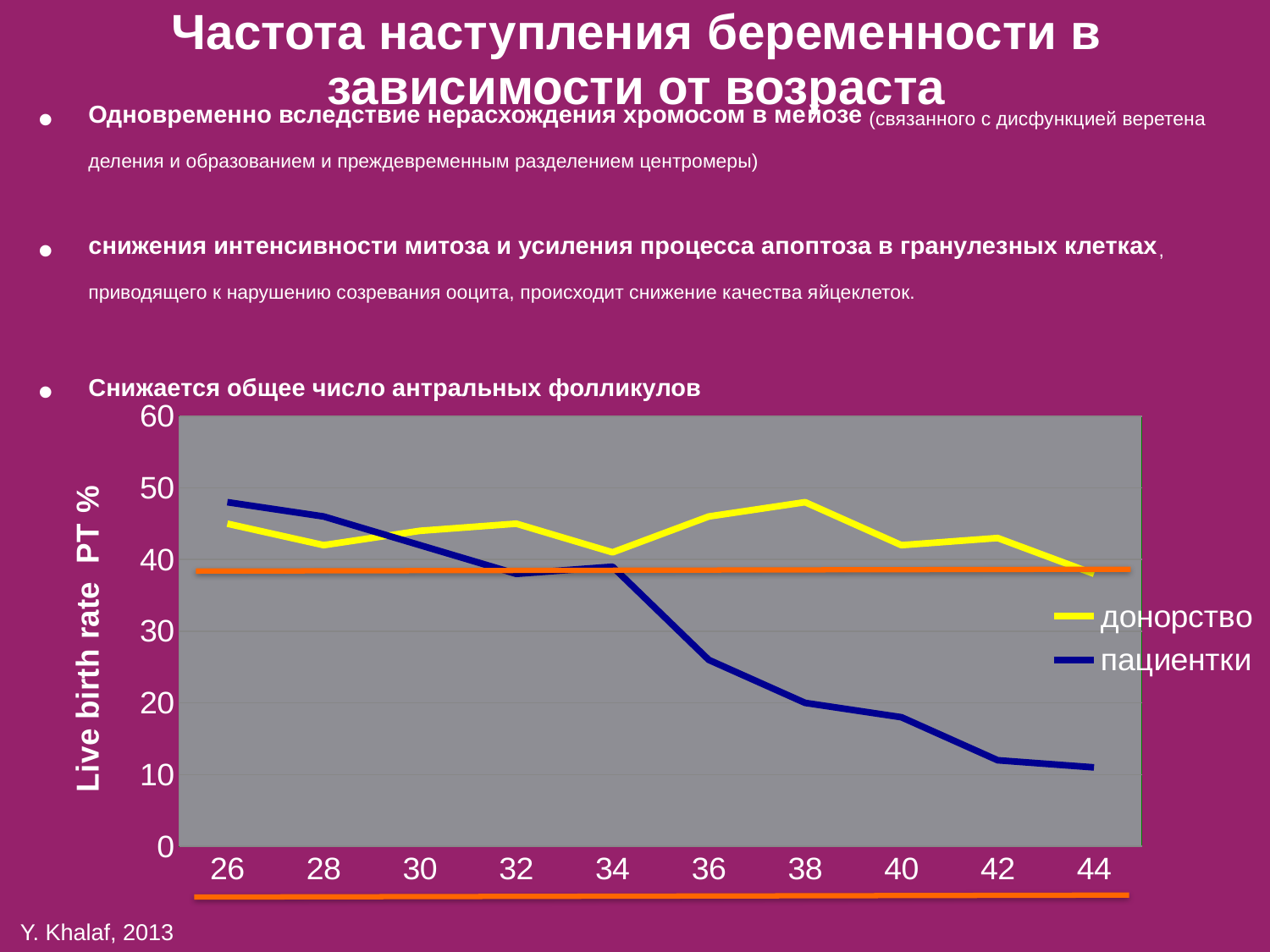
How many series does the chart legend list? 2 What are the two series named in the chart legend? донорство and пациентки What kind of chart is shown on the slide? line chart How many age values are marked along the x axis of the chart? 10 At which age is the пациентки series at its lowest? 44 At age 44, which series has the larger value, донорство or пациентки? донорство At which age is the пациентки series at its highest? 26 At which age is the донорство series at its highest? 38 What is the label of the vertical axis of the chart? Live birth rate PT % Is the value for пациентки at age 40 greater or less than 20? less Is the value for пациентки at age 36 greater or less than 30? less Does the пациентки series rise or fall as age increases along the x axis? fall